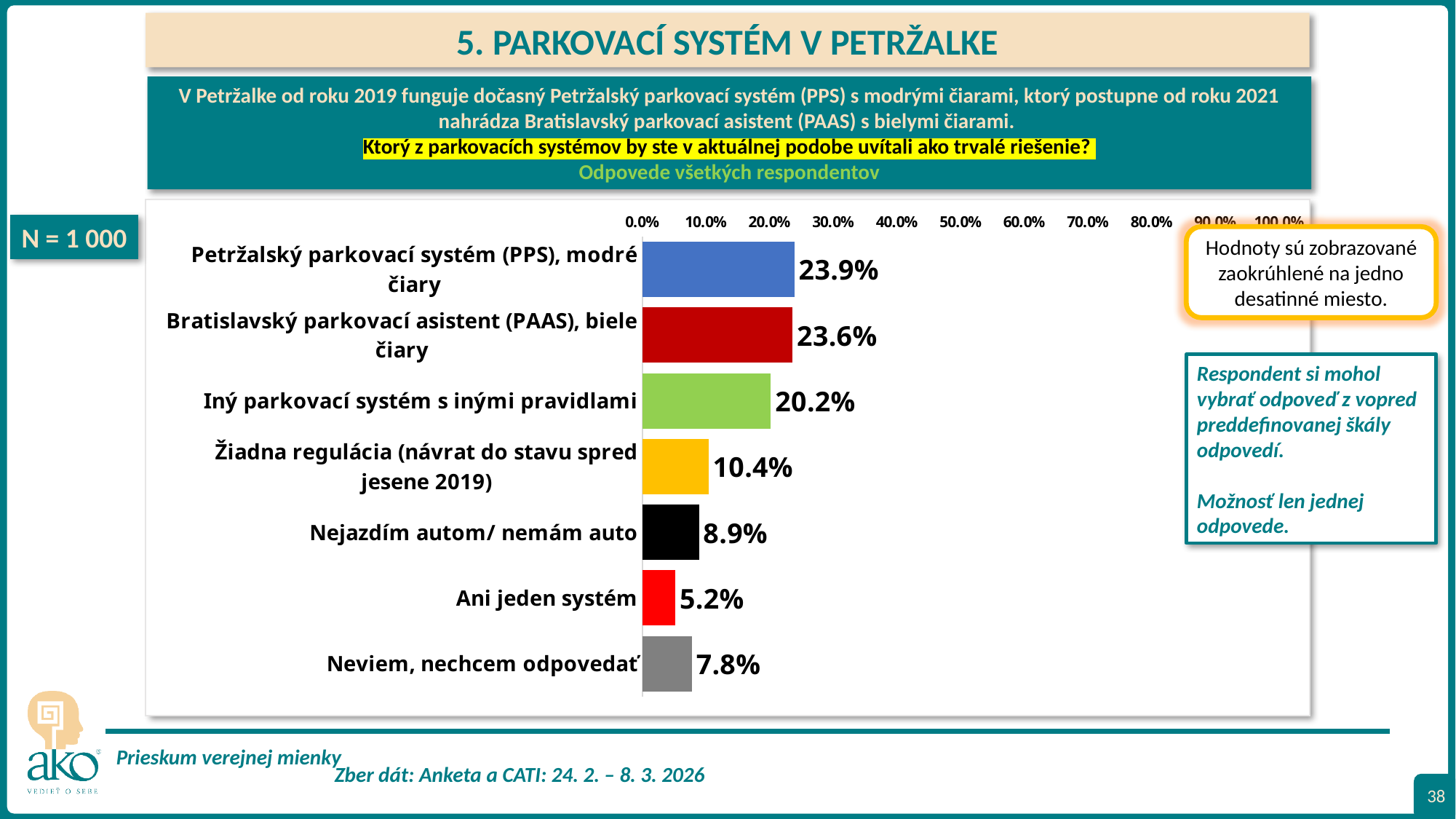
What type of chart is shown on the slide? bar chart Which is larger: the value for 'Nejazdím autom/ nemám auto' or for 'Neviem, nechcem odpovedať'? Nejazdím autom/ nemám auto Which category has the lowest value in the chart? Ani jeden systém Which category has the highest value in the chart? Petržalský parkovací systém (PPS), modré čiary What colour is the bar for 'Bratislavský parkovací asistent (PAAS), biele čiary'? red What percentage of respondents chose 'Petržalský parkovací systém (PPS), modré čiary'? 23.9% Is the value for 'Žiadna regulácia (návrat do stavu spred jesene 2019)' greater or less than 20.0%? less What is the value shown for 'Bratislavský parkovací asistent (PAAS), biele čiary'? 23.6% What is the value for 'Neviem, nechcem odpovedať'? 7.8% What is the difference between the values for 'Iný parkovací systém s inými pravidlami' and 'Žiadna regulácia (návrat do stavu spred jesene 2019)'? 9.8 percentage points What percentage is shown for 'Žiadna regulácia (návrat do stavu spred jesene 2019)'? 10.4% How many categories are shown in the bar chart? 7